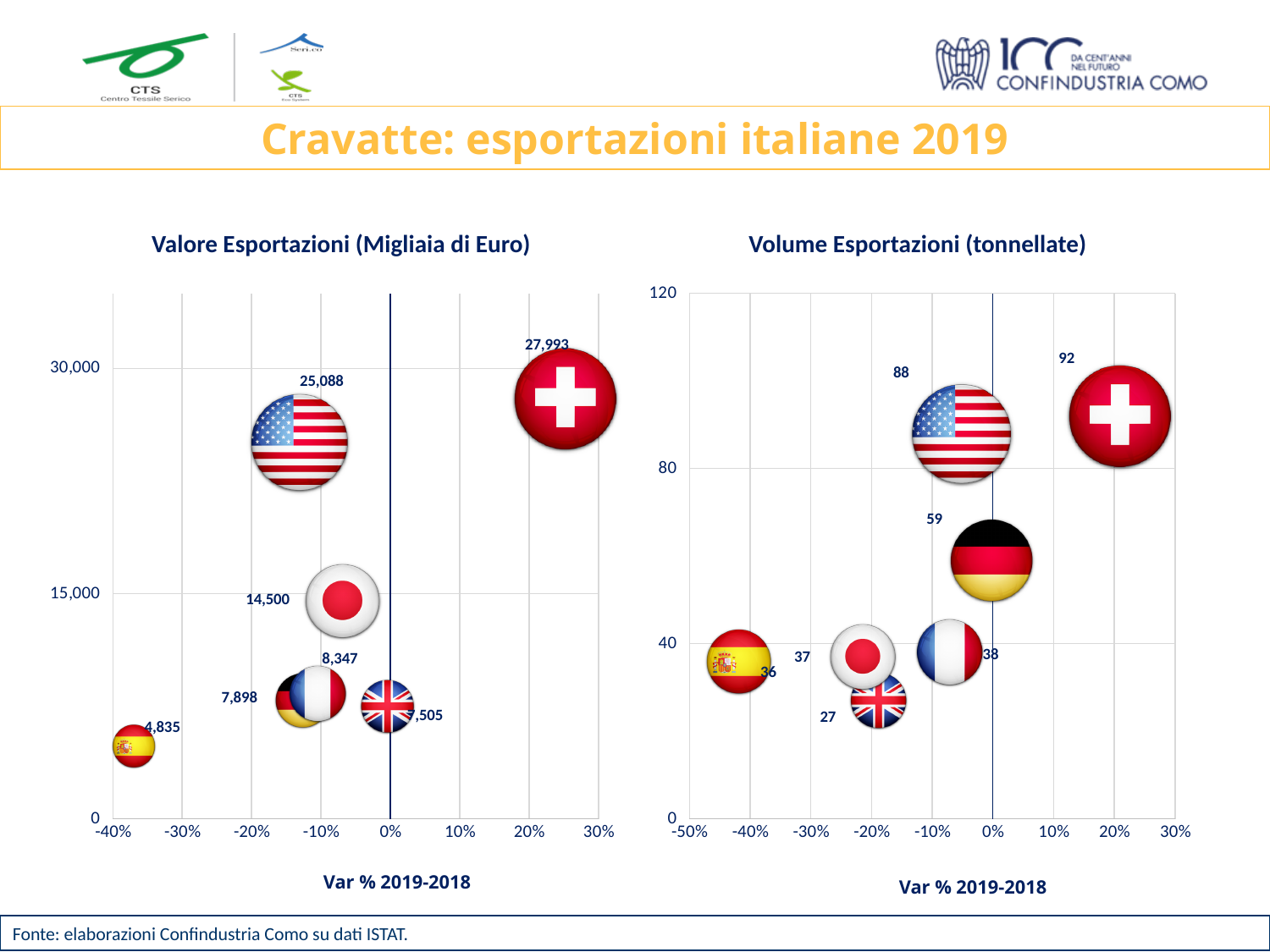
On the 'Volume Esportazioni (tonnellate)' chart, what value is labelled on the bubble with the German flag? 59 What kind of chart is the 'Volume Esportazioni (tonnellate)' chart? Bubble chart On the 'Valore Esportazioni (Migliaia di Euro)' chart, what value is labelled on the bubble with the Spanish flag? 4,835 On the 'Valore Esportazioni (Migliaia di Euro)' chart, what value is labelled on the bubble with the United States flag? 25,088 On the 'Valore Esportazioni (Migliaia di Euro)' chart, what is the difference between the Swiss bubble value and the United States bubble value? 2,905 On the 'Valore Esportazioni (Migliaia di Euro)' chart, what value is labelled on the bubble with the Swiss flag? 27,993 On the 'Valore Esportazioni (Migliaia di Euro)' chart, which country's bubble has the lowest export value? Spain On the 'Volume Esportazioni (tonnellate)' chart, which country's bubble has the lowest volume? United Kingdom On the 'Volume Esportazioni (tonnellate)' chart, how many country bubbles are plotted? 7 On the 'Valore Esportazioni (Migliaia di Euro)' chart, is the Var % 2019-2018 for the Swiss bubble greater or less than 20%? greater On the 'Volume Esportazioni (tonnellate)' chart, what value is labelled on the bubble with the Swiss flag? 92 On the 'Valore Esportazioni (Migliaia di Euro)' chart, what value is labelled on the bubble with the Japanese flag? 14,500